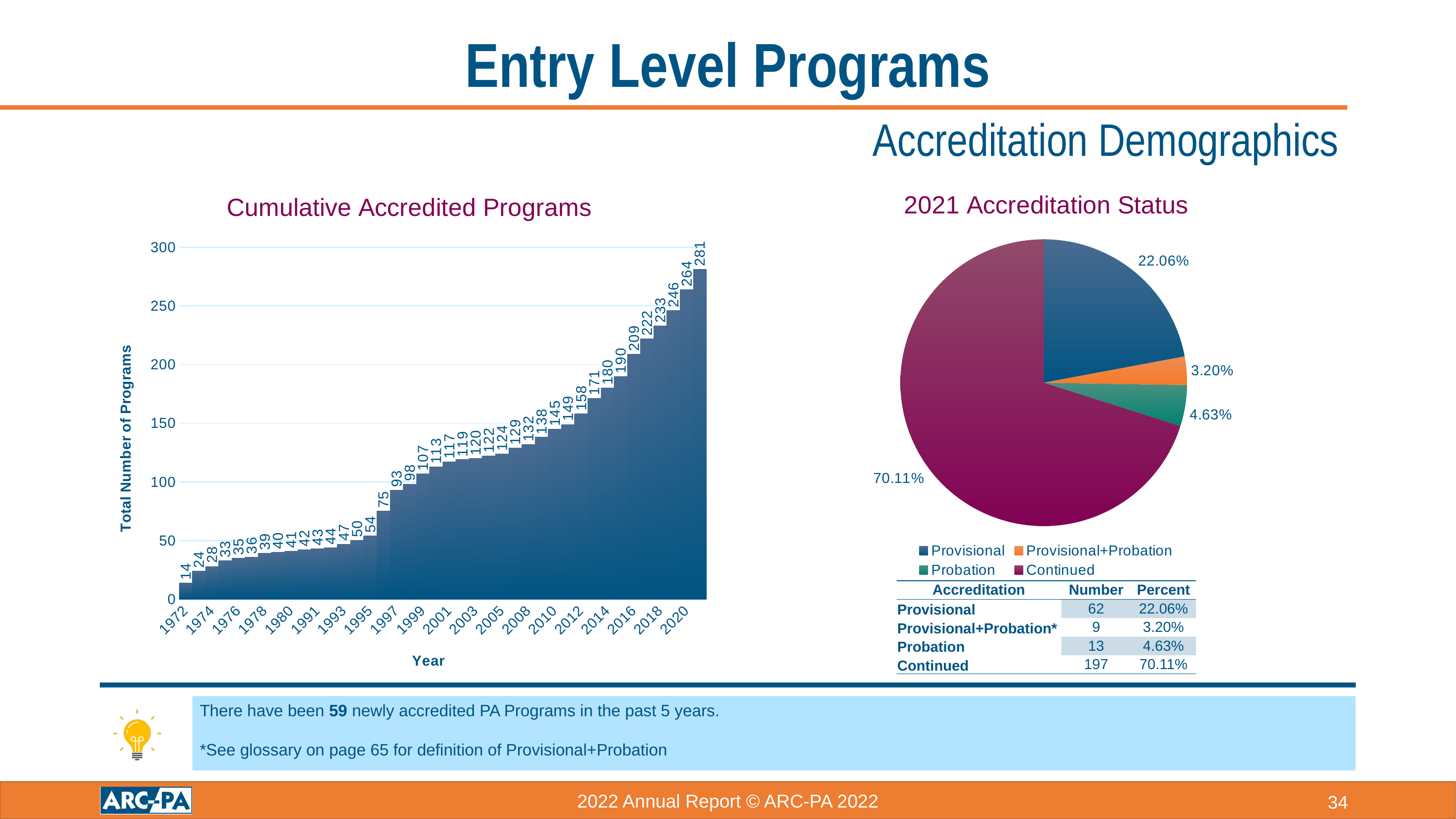
What is the title of the y axis in the Cumulative Accredited Programs chart? Total Number of Programs In the 2021 Accreditation Status pie chart, which is larger: the Probation share or the Provisional+Probation share? Probation What kind of chart is the Cumulative Accredited Programs chart? bar chart In the Cumulative Accredited Programs chart, is the value for 1972 greater or less than 50? less In the 2021 Accreditation Status pie chart, which accreditation status has the smallest slice? Provisional+Probation How many entries does the legend of the 2021 Accreditation Status pie chart list? 4 In the 2021 Accreditation Status pie chart, which accreditation status has the largest slice? Continued In the 2021 Accreditation Status pie chart, what percentage of programs have Continued accreditation? 70.11% In the 2021 Accreditation Status table, how many programs have Provisional accreditation? 62 In the Cumulative Accredited Programs chart, do the values rise or fall from 1972 to the most recent year? rise In the Cumulative Accredited Programs chart, what is the value for 1972? 14 In the Cumulative Accredited Programs chart, what is the highest value shown? 281